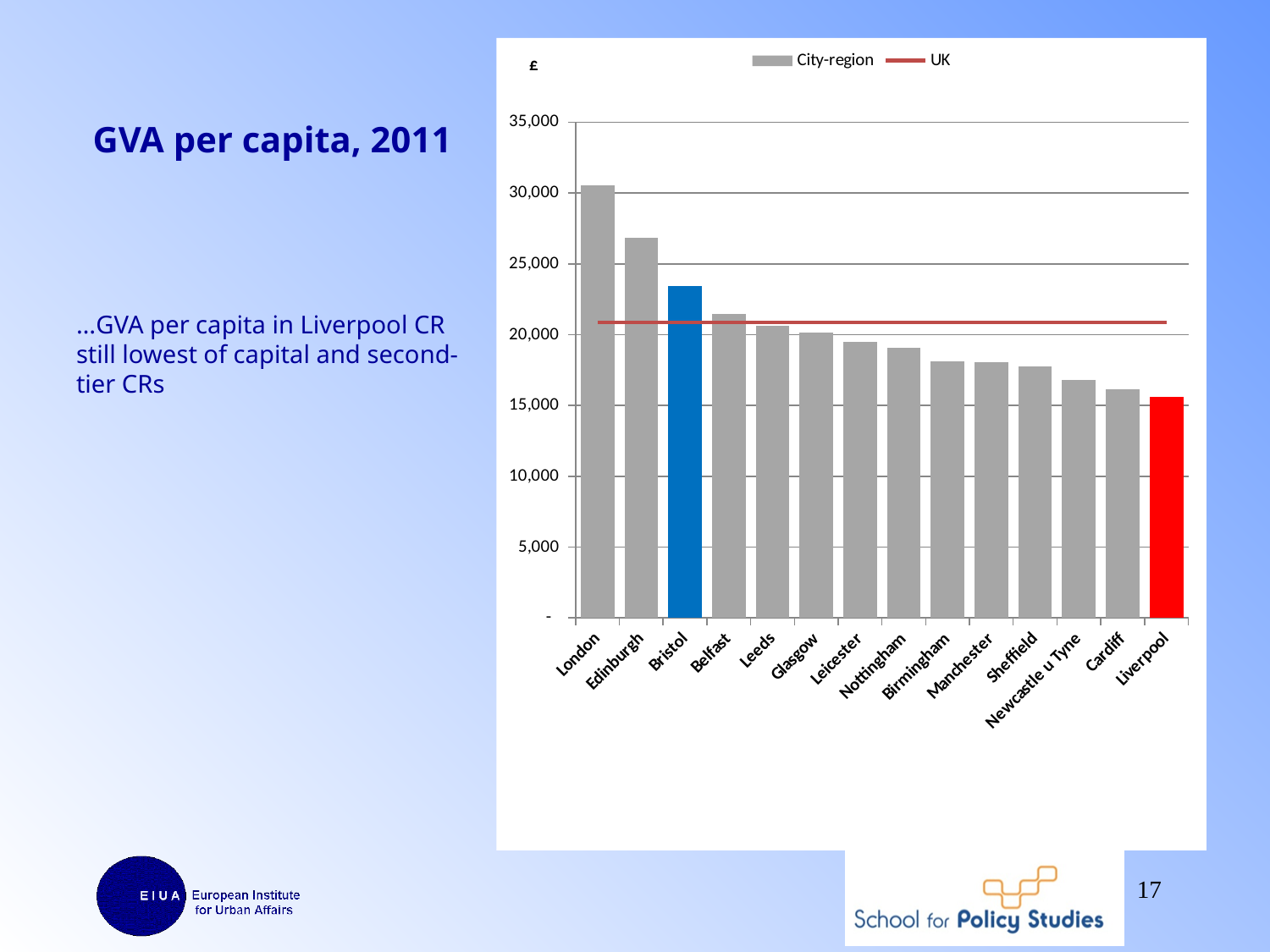
Do the bar values rise or fall moving from left to right along the x axis? fall Is the value for Edinburgh greater or less than 25,000? greater How many series does the legend list? 2 What kind of chart is shown on the slide? bar chart Which city-region has the lowest GVA per capita in the chart? Liverpool What colour is the bar for Liverpool? red Is the value for Birmingham greater or less than 20,000? less Which has the larger GVA per capita, Edinburgh or Bristol? Edinburgh Which city-region has the highest GVA per capita in the chart? London How many city-regions are plotted on the x axis? 14 Is the value for Bristol greater or less than 20,000? greater